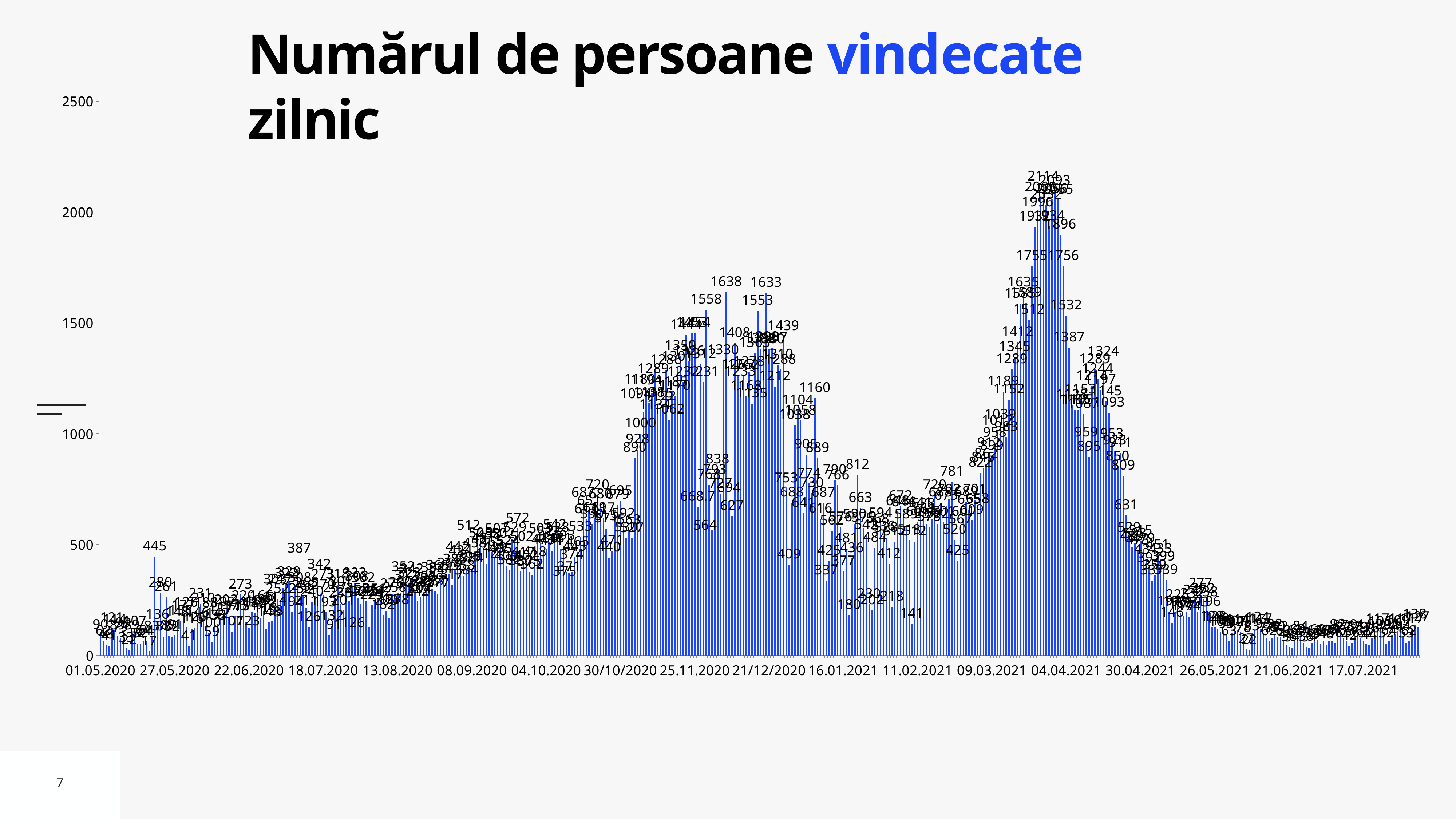
What kind of chart is shown on the slide? bar chart Is the value for the first bar, at 01.05.2020, greater or less than 500? less What is the title of the chart on the slide? Numărul de persoane vindecate zilnic What is the highest daily value labeled on the chart? 2114 Is the highest value on the chart greater or less than 2000? greater Do the values rise or fall between 09.03.2021 and 04.04.2021? rise Do the values rise or fall between 04.04.2021 and 26.05.2021? fall What is the highest tick value shown on the y axis? 2500 Is the value for the bar at the 17.07.2021 tick greater or less than 500? less Which peak is higher: the one around 04.04.2021 or the one around 25.11.2020? the one around 04.04.2021 How many date labels are shown on the x axis? 18